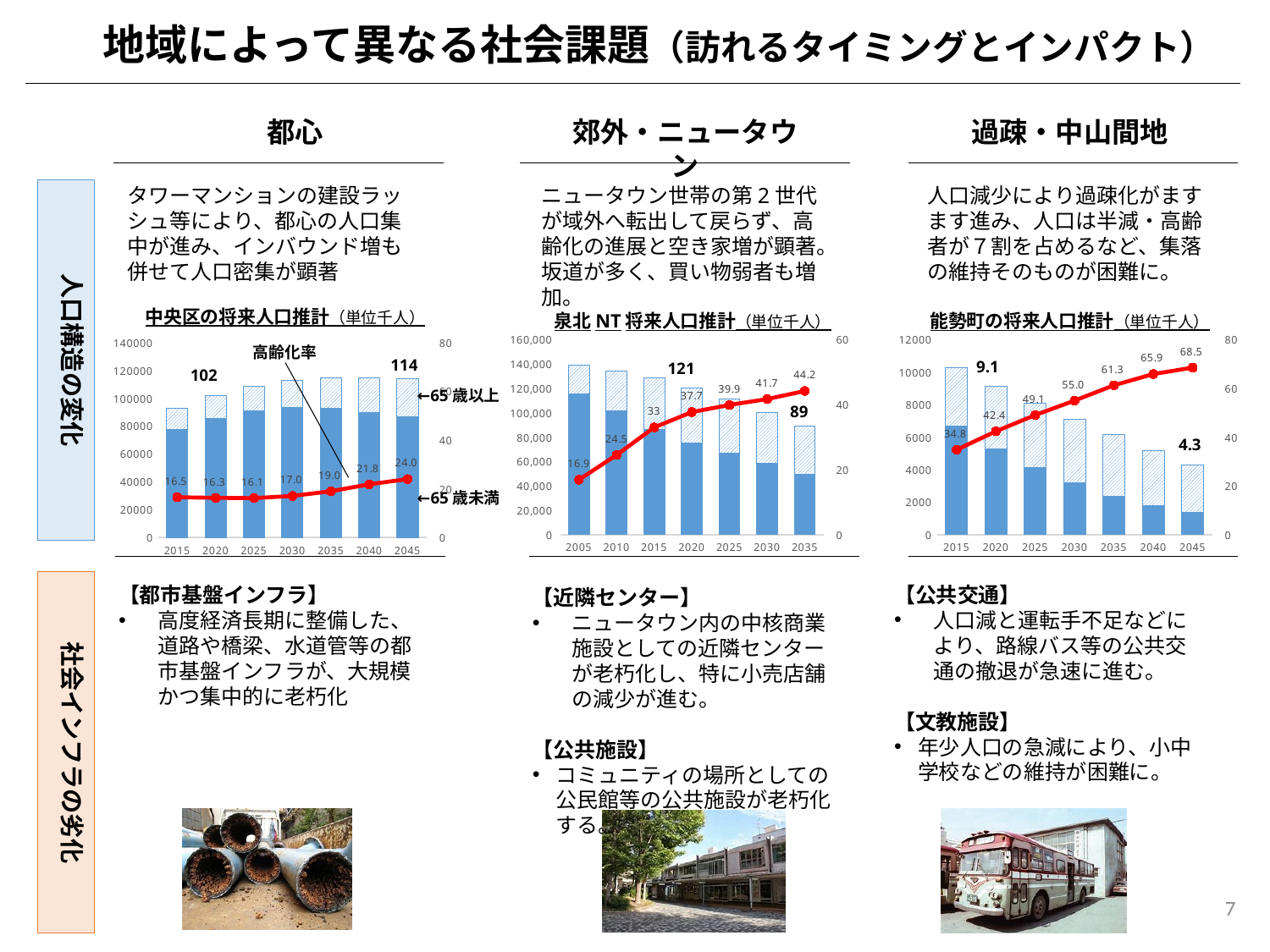
In the 中央区の将来人口推計 chart, what is the aging rate (高齢化率) value labelled for 2045? 24.0 In the 能勢町の将来人口推計 chart, does the red line rise or fall from 2015 to 2045? rise In the 泉北NT将来人口推計 chart, what is the line value labelled for 2005? 16.9 In the 能勢町の将来人口推計 chart, which year has the highest aging rate on the line? 2045 In the 能勢町の将来人口推計 chart, what total population value is labelled for 2045? 4.3 In the 泉北NT将来人口推計 chart, which year has the larger labelled total population, 2015 or 2035? 2015 In the 中央区の将来人口推計 chart, what is the difference between the labelled totals for 2045 (114) and 2015 (102)? 12 In the 能勢町の将来人口推計 chart, what is the difference between the labelled totals for 2015 (9.1) and 2045 (4.3)? 4.8 How many years are shown on the x axis of the 泉北NT将来人口推計 chart? 7 In the 能勢町の将来人口推計 chart, is the total bar height for 2030 greater or less than 8000? less In the 中央区の将来人口推計 chart, which year has the lowest labelled aging rate? 2025 In the 泉北NT将来人口推計 chart, what is the difference between the labelled totals for 2015 (121) and 2035 (89)? 32